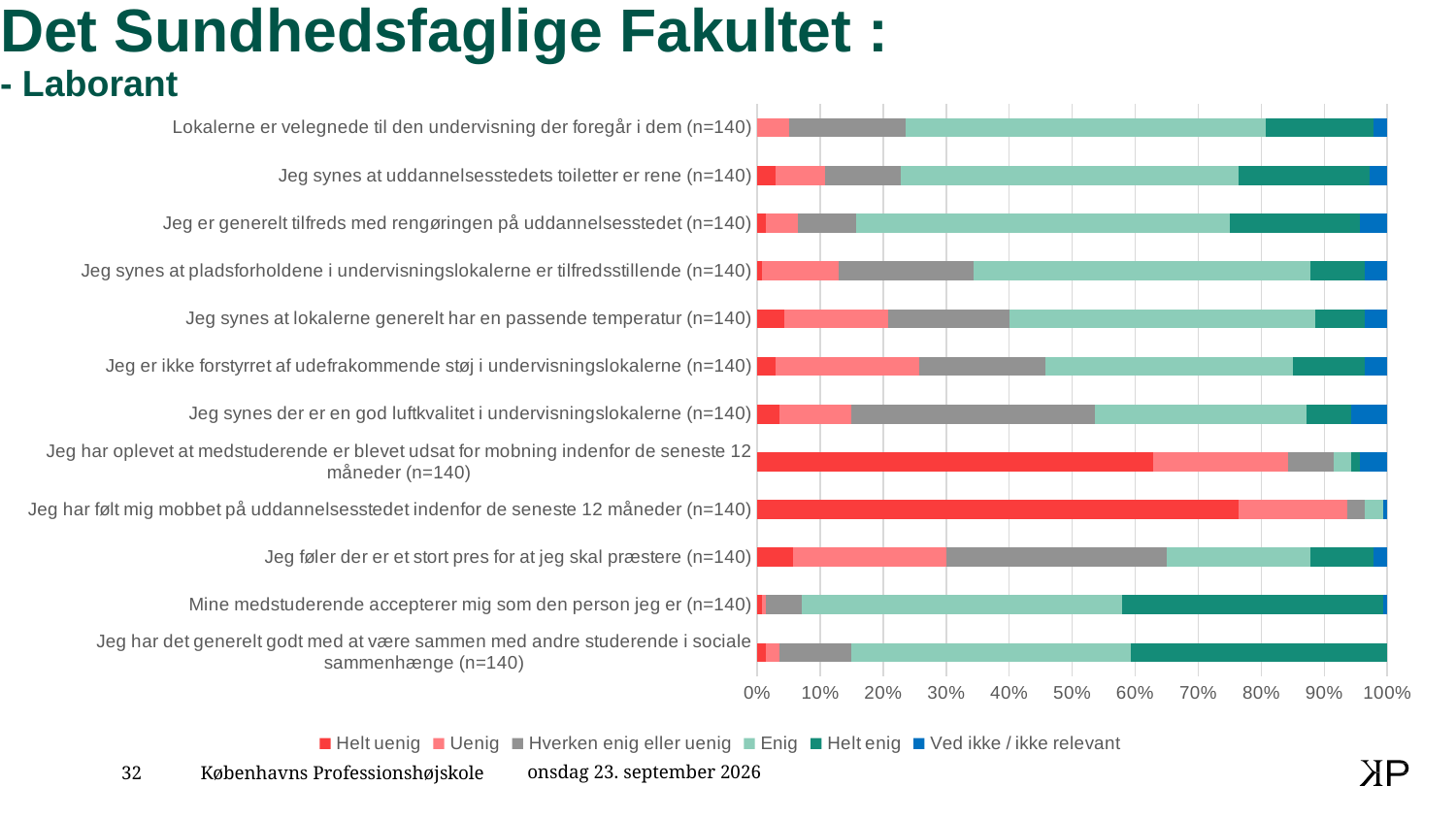
Which series is listed first in the legend? Helt uenig What kind of chart is shown on the slide? Stacked bar chart Which statement has the largest 'Helt uenig' share? Jeg har følt mig mobbet på uddannelsesstedet indenfor de seneste 12 måneder (n=140) Which has the larger 'Helt uenig' share: 'Jeg har følt mig mobbet på uddannelsesstedet indenfor de seneste 12 måneder (n=140)' or 'Jeg har oplevet at medstuderende er blevet udsat for mobning indenfor de seneste 12 måneder (n=140)'? Jeg har følt mig mobbet på uddannelsesstedet indenfor de seneste 12 måneder (n=140) Is the 'Hverken enig eller uenig' share for 'Jeg føler der er et stort pres for at jeg skal præstere (n=140)' greater or less than 20%? greater What is the sample size (n) shown for each statement in the chart? 140 Is the 'Enig' share for 'Lokalerne er velegnede til den undervisning der foregår i dem (n=140)' greater or less than 50%? greater Which has the larger 'Helt enig' share: 'Mine medstuderende accepterer mig som den person jeg er (n=140)' or 'Jeg synes at lokalerne generelt har en passende temperatur (n=140)'? Mine medstuderende accepterer mig som den person jeg er (n=140) Is the 'Helt uenig' share for 'Jeg har oplevet at medstuderende er blevet udsat for mobning indenfor de seneste 12 måneder (n=140)' greater or less than 50%? greater How many statements (categories) are plotted in the chart? 12 How many series does the legend list? 6